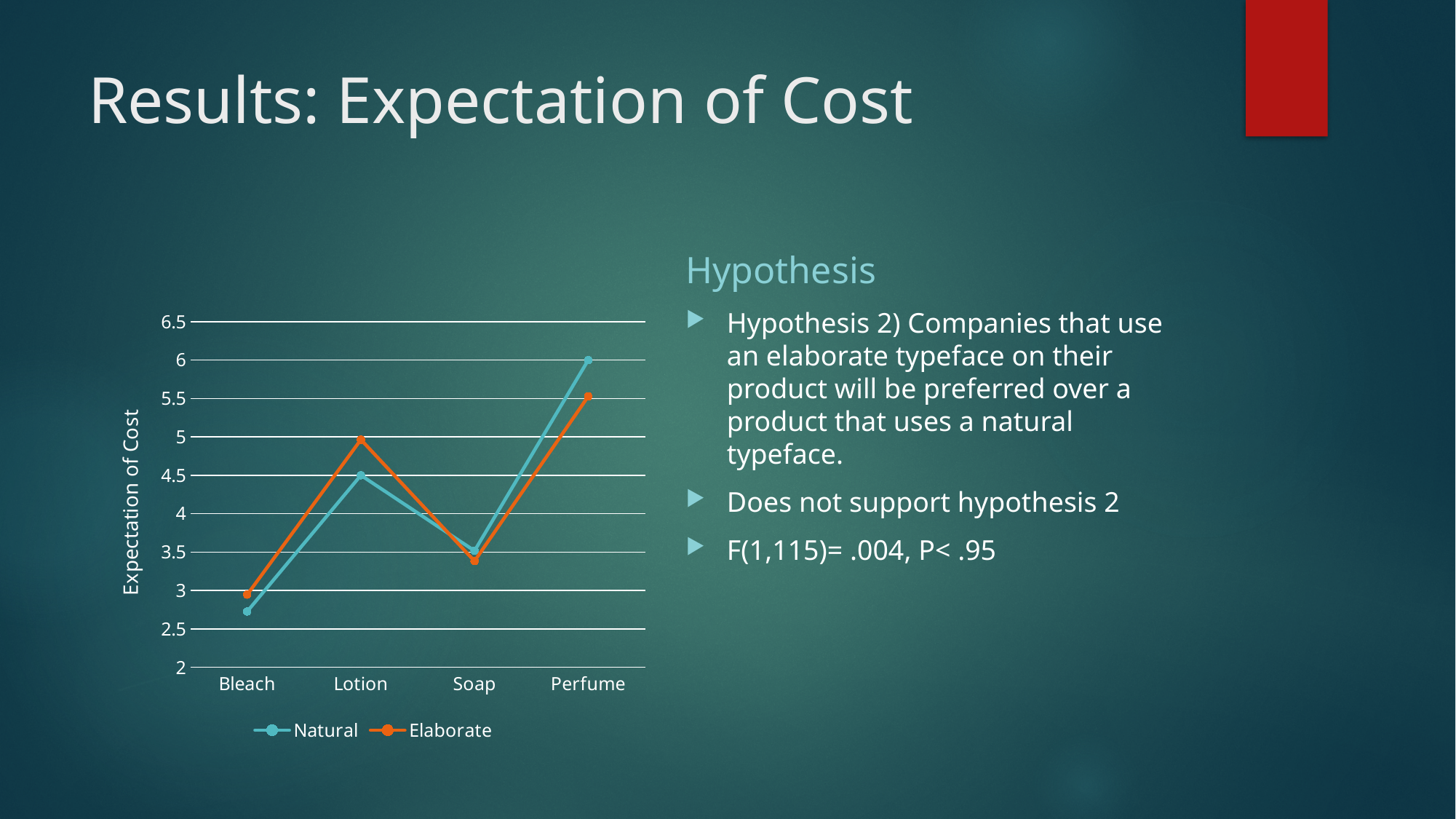
What is the label on the chart's vertical axis? Expectation of Cost How many series does the chart's legend list? 2 For the Natural series, which product has the lowest expectation of cost? Bleach Is the Elaborate value for Perfume greater or less than 5? greater Is the Elaborate value for Bleach greater or less than 3? less For Perfume, which series has the higher value, Natural or Elaborate? Natural How many product categories are plotted along the x axis? 4 What kind of chart is shown on the slide? line chart For the Elaborate series, which product has the highest expectation of cost? Perfume For Lotion, which series has the higher value, Natural or Elaborate? Elaborate For the Elaborate series, which product has the lowest expectation of cost? Bleach For the Natural series, which product has the highest expectation of cost? Perfume